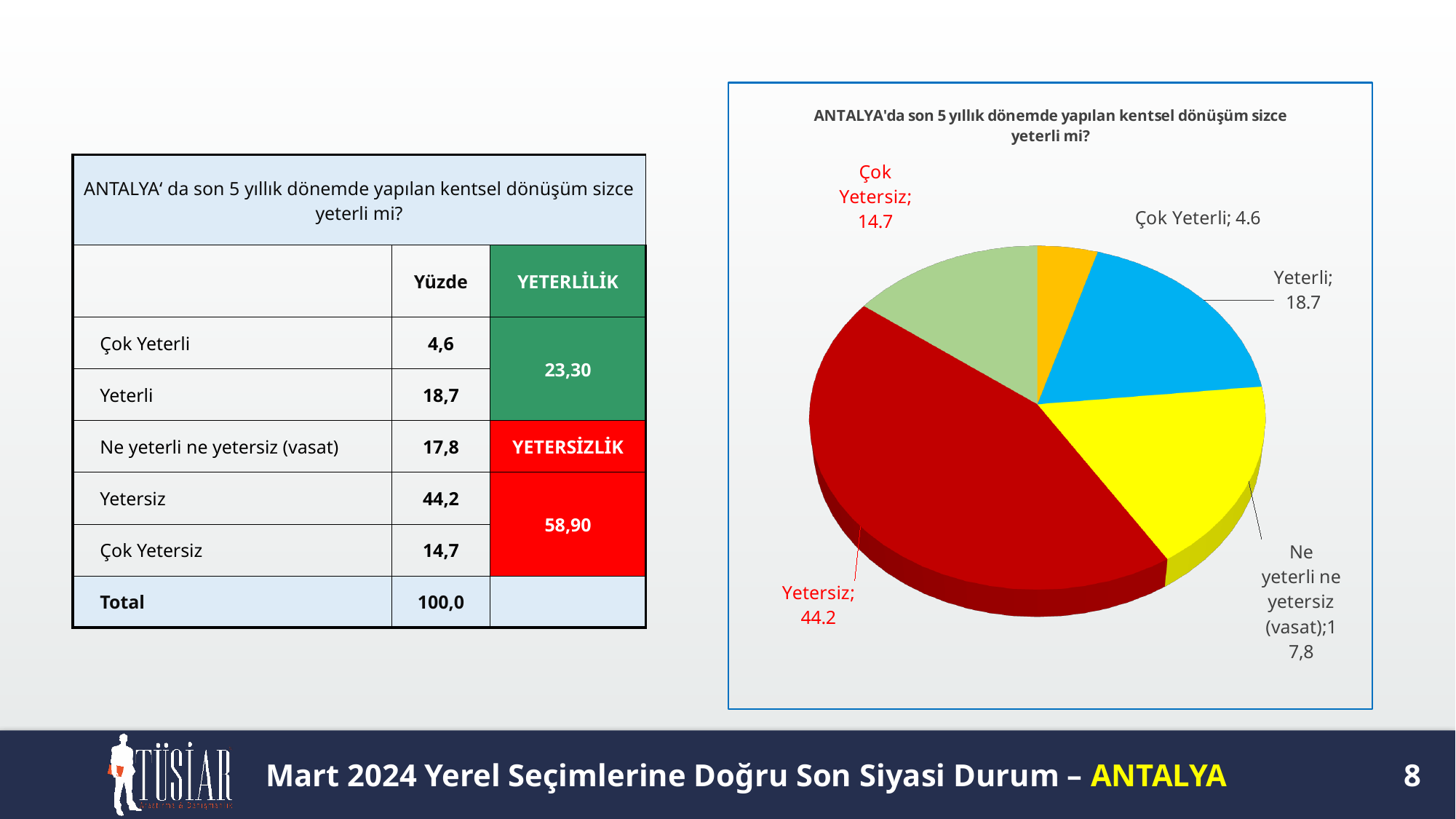
What is the value for Yetersiz in the pie chart? 44.2 How many slices does the pie chart have? 5 Which is larger in the pie chart, Yeterli or Çok Yetersiz? Yeterli Which category has the smallest slice in the pie chart? Çok Yeterli What kind of chart is shown on the slide? pie chart What is the difference between the values for Yetersiz and Yeterli in the pie chart? 25.5 What is the title of the pie chart? ANTALYA'da son 5 yıllık dönemde yapılan kentsel dönüşüm sizce yeterli mi? What is the value for Çok Yeterli in the pie chart? 4.6 What is the value for Çok Yetersiz in the pie chart? 14.7 Which category has the largest slice in the pie chart? Yetersiz What colour is the Yetersiz slice in the pie chart? red What is the value for Yeterli in the pie chart? 18.7